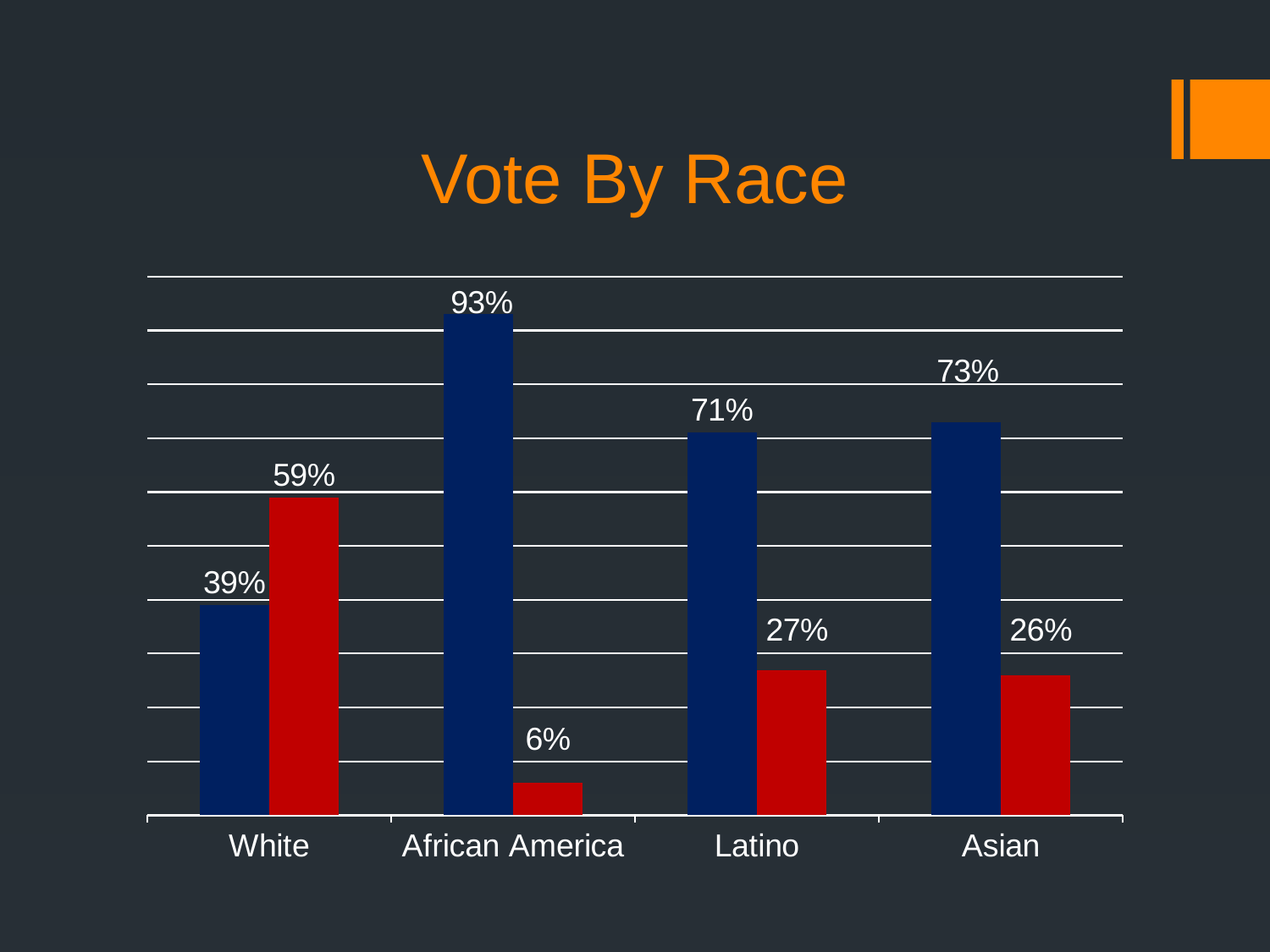
Which category has the highest blue bar? African America How many categories are shown on the x axis? 4 What kind of chart is shown on the slide? bar chart Which is larger for White, the blue bar or the red bar? the red bar Which category has the lowest red bar? African America What is the title of the chart? Vote By Race What is the value of the red bar for White? 59% What is the value of the blue bar for Asian? 73% What is the difference between the blue and red bars for White? 20% What is the value of the red bar for Latino? 27% What is the difference between the blue bars for Asian and Latino? 2% What is the value of the blue bar for African America? 93%